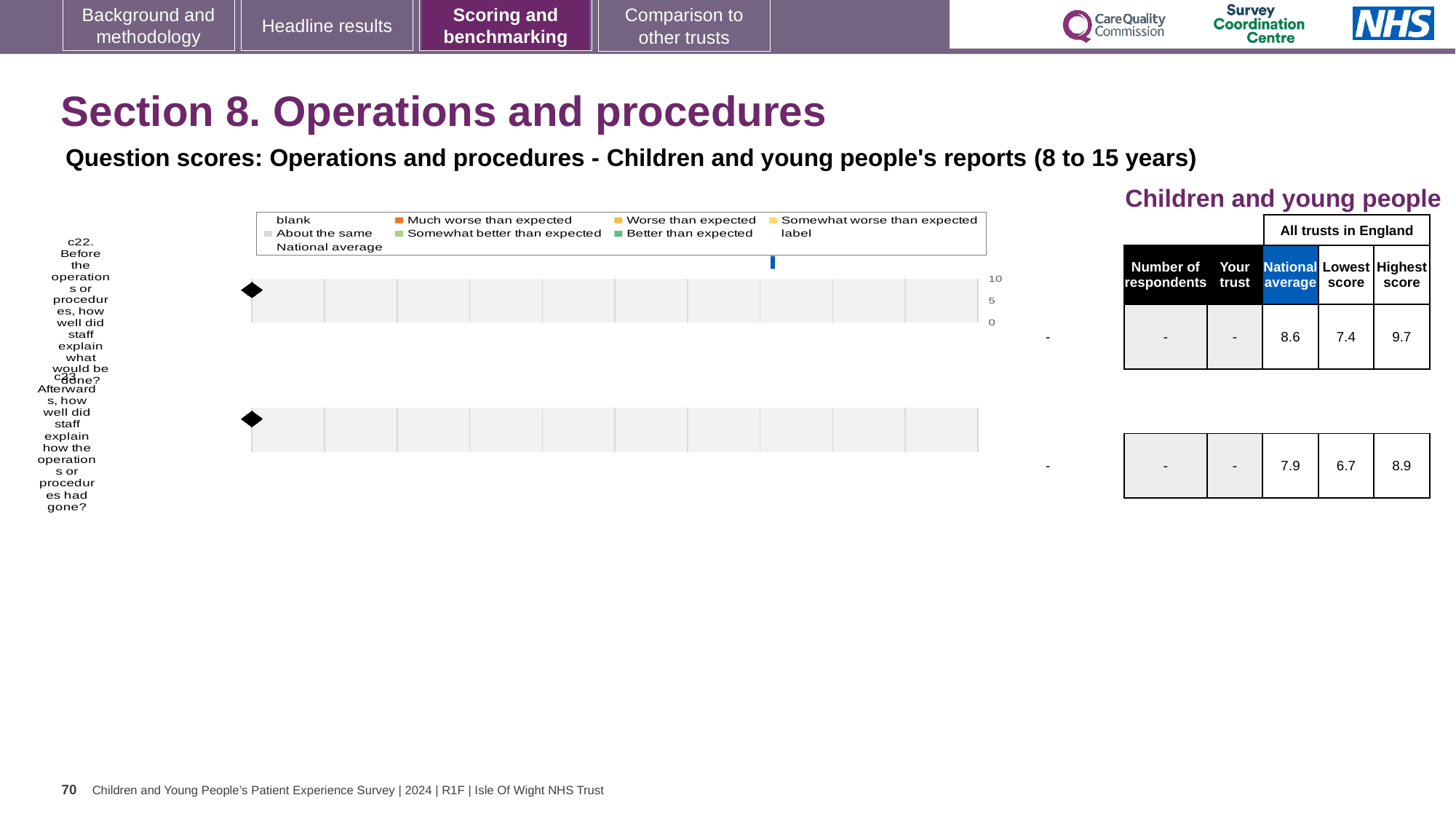
What is the national average score for c23 (Afterwards, how well did staff explain how the operations or procedures had gone?)? 7.9 What is the difference between the highest and lowest scores for c22? 2.3 What is the lowest score among all trusts in England for c22? 7.4 What is the maximum value shown on the chart's numeric axis? 10 How many question categories are plotted on the chart? 2 What is the difference between the highest and lowest scores for c23? 2.2 What is the highest score among all trusts in England for c22? 9.7 Which question has the higher national average score, c22 or c23? c22 What is the national average score for c22 (Before the operations or procedures, how well did staff explain what would be done?)? 8.6 What kind of chart is shown on the slide? bar chart What is the highest score among all trusts in England for c23? 8.9 What is the lowest score among all trusts in England for c23? 6.7